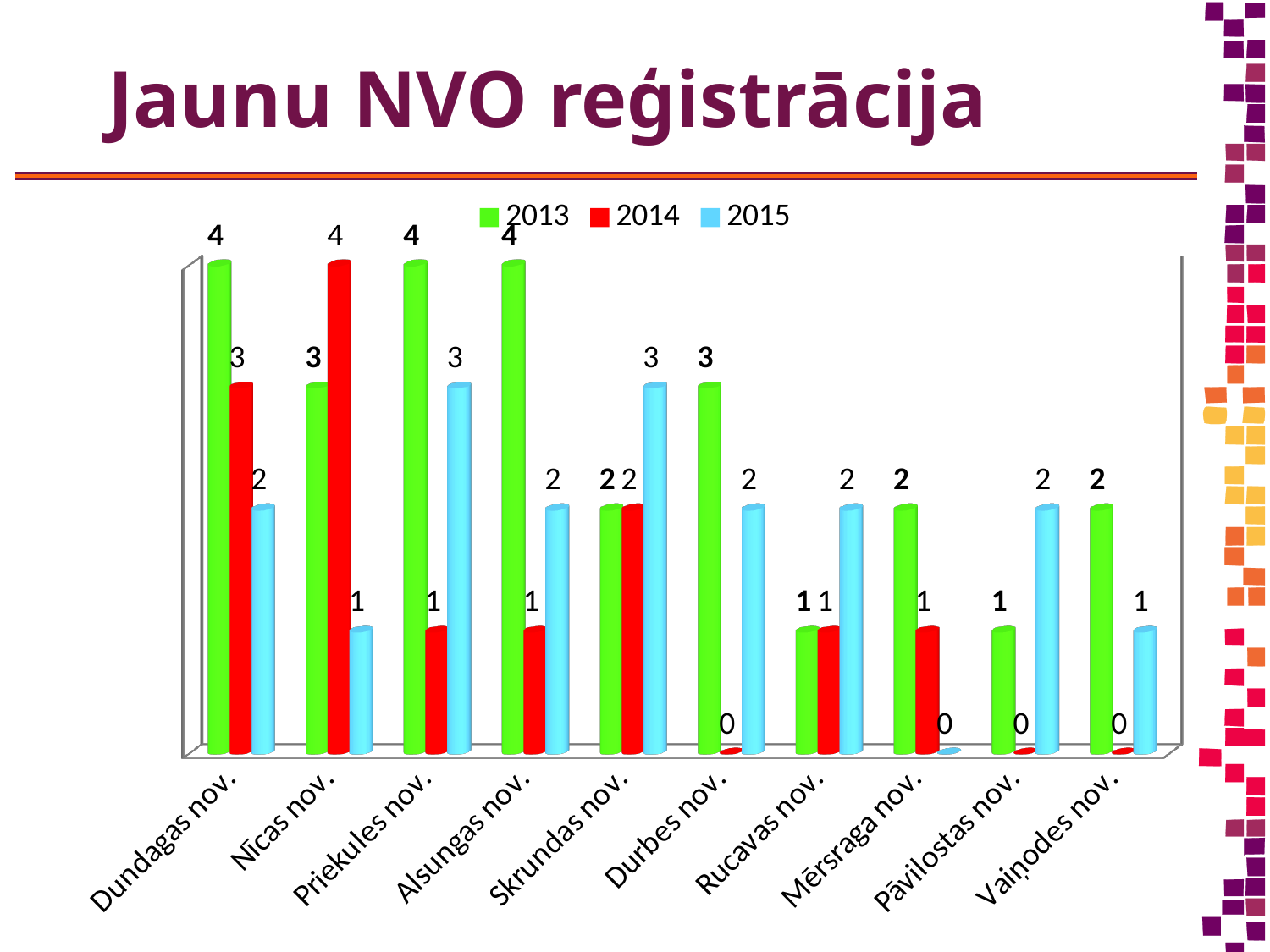
What is the 2014 value for Durbes nov.? 0 How many series does the legend list? 3 What is the 2014 value for Nīcas nov.? 4 Which is larger for Skrundas nov., the 2013 value or the 2015 value? 2015 What is the 2015 value for Priekules nov.? 3 What is the 2015 value for Pāvilostas nov.? 2 What is the difference between the 2013 and 2014 values for Alsungas nov.? 3 How many categories are shown on the x axis? 10 What kind of chart is shown on the slide? Bar chart Which category has the lowest 2015 value? Mērsraga nov. What is the 2013 value for Dundagas nov.? 4 What is the title of the slide? Jaunu NVO reģistrācija